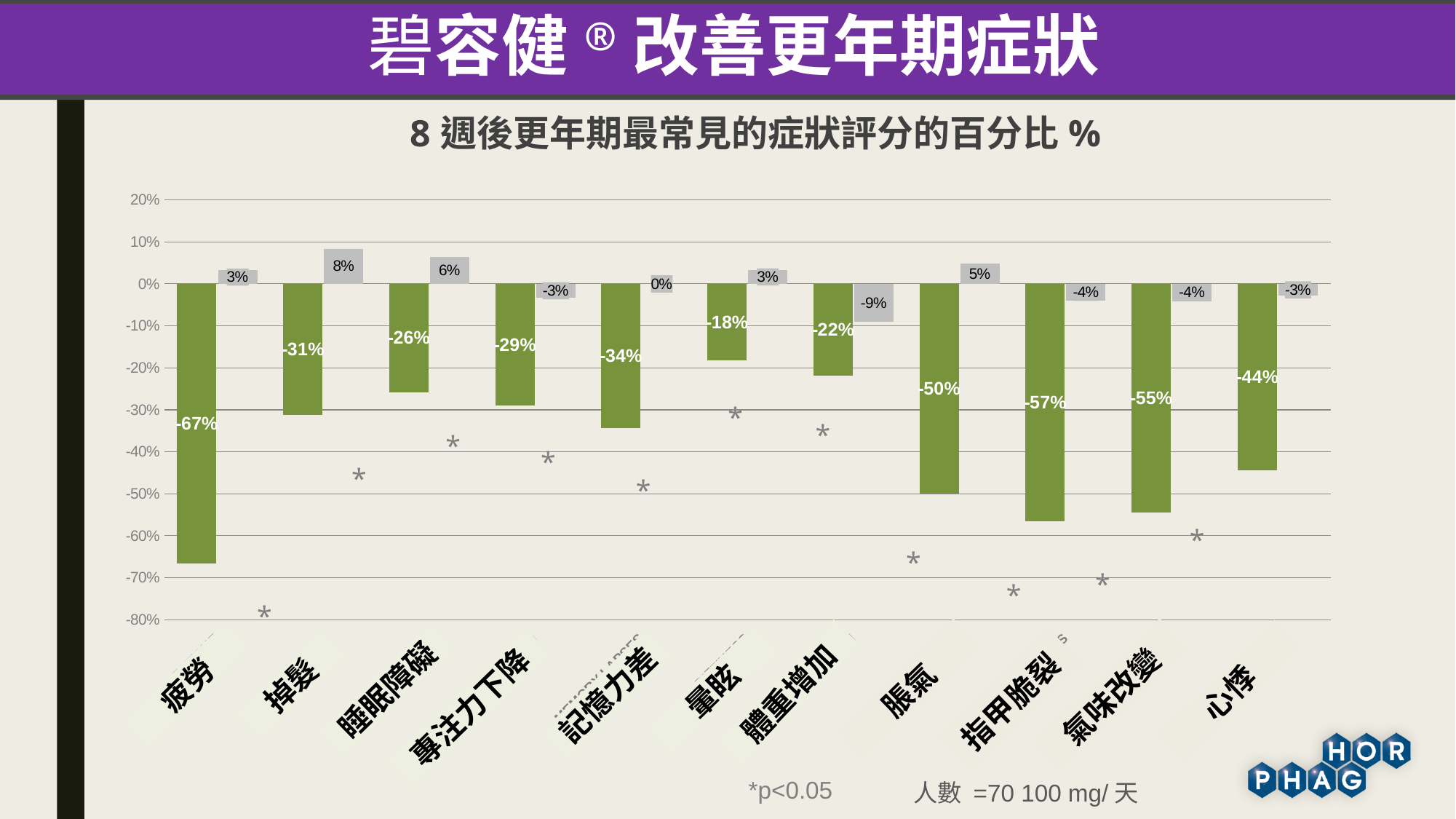
What is the value of the green bar for 疲勞? -67% What is the grey value shown for 掉髮? 8% Which has a larger reduction in the green bar, 脹氣 or 記憶力差? 脹氣 What type of chart is shown on the slide? bar chart How many symptom categories are shown on the x axis? 11 What is the grey value shown for 記憶力差? 0% What is the grey value shown for 體重增加? -9% What is the value of the green bar for 心悸? -44% Which category has the smallest reduction (green bar closest to 0%)? 暈眩 What is the title of the chart? 8 週後更年期最常見的症狀評分的百分比 % What is the difference between the green bar values for 指甲脆裂 and 氣味改變? 2% Which category has the lowest (most negative) green bar value? 疲勞